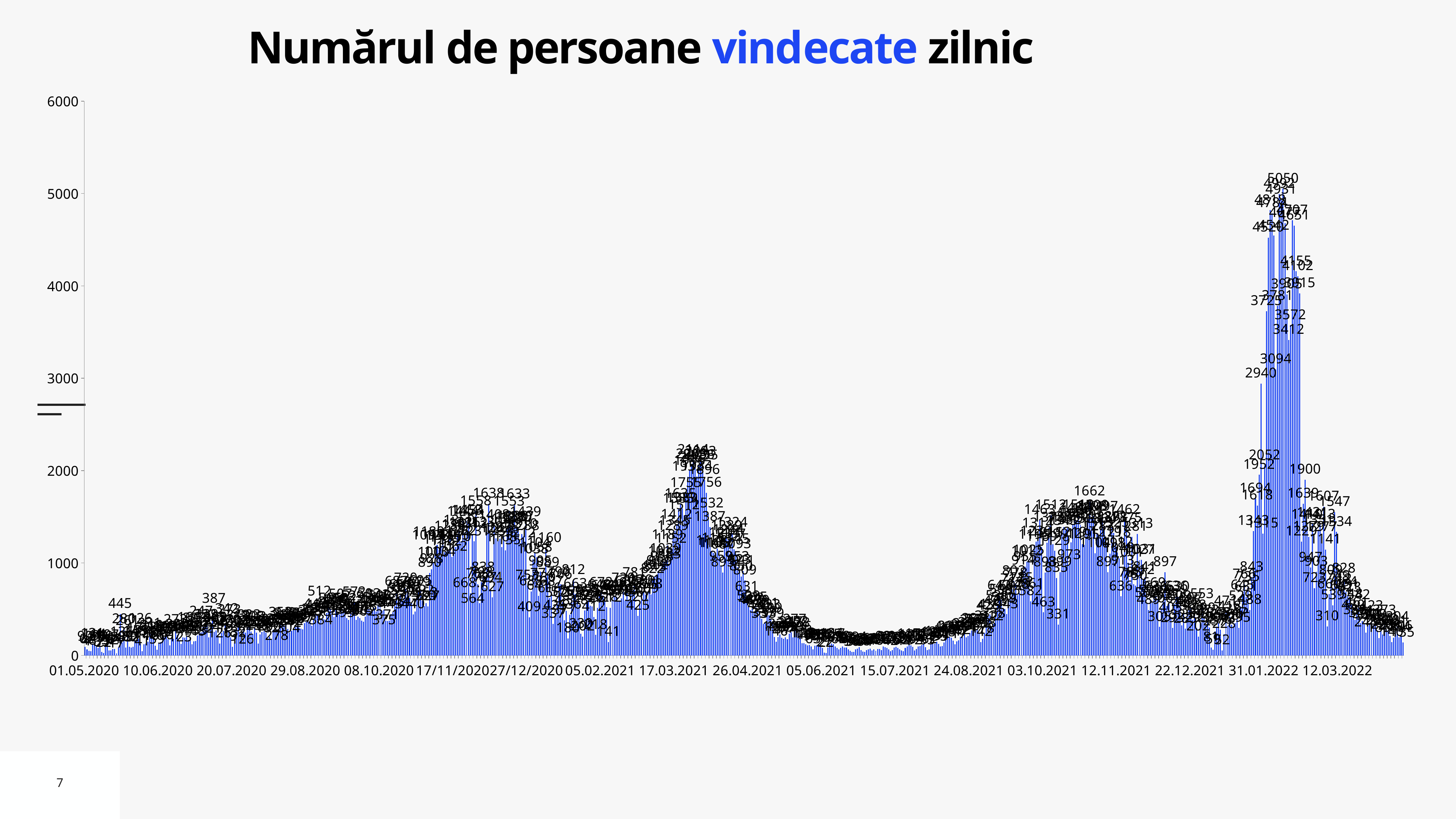
What is the title of the chart? Numărul de persoane vindecate zilnic Is the tallest bar on the chart greater or less than 4000? greater What kind of chart is shown on the slide? bar chart Which peak is higher: the one around 17.03.2021 or the one around 31.01.2022? the one around 31.01.2022 What is the first date label on the x axis? 01.05.2020 What is the highest value labelled on the chart? 5050 What is the highest value labelled in the wave around 12.11.2021? 1662 Are the values around 15.07.2021 greater or less than 1000? less Which peak is higher: the one around 17.03.2021 or the one around 12.11.2021? the one around 17.03.2021 After the peak in early February 2022, do the values rise or fall toward 12.03.2022? fall What is the highest value shown on the y axis? 6000 Between 24.08.2021 and 12.11.2021, do the values generally rise or fall? rise